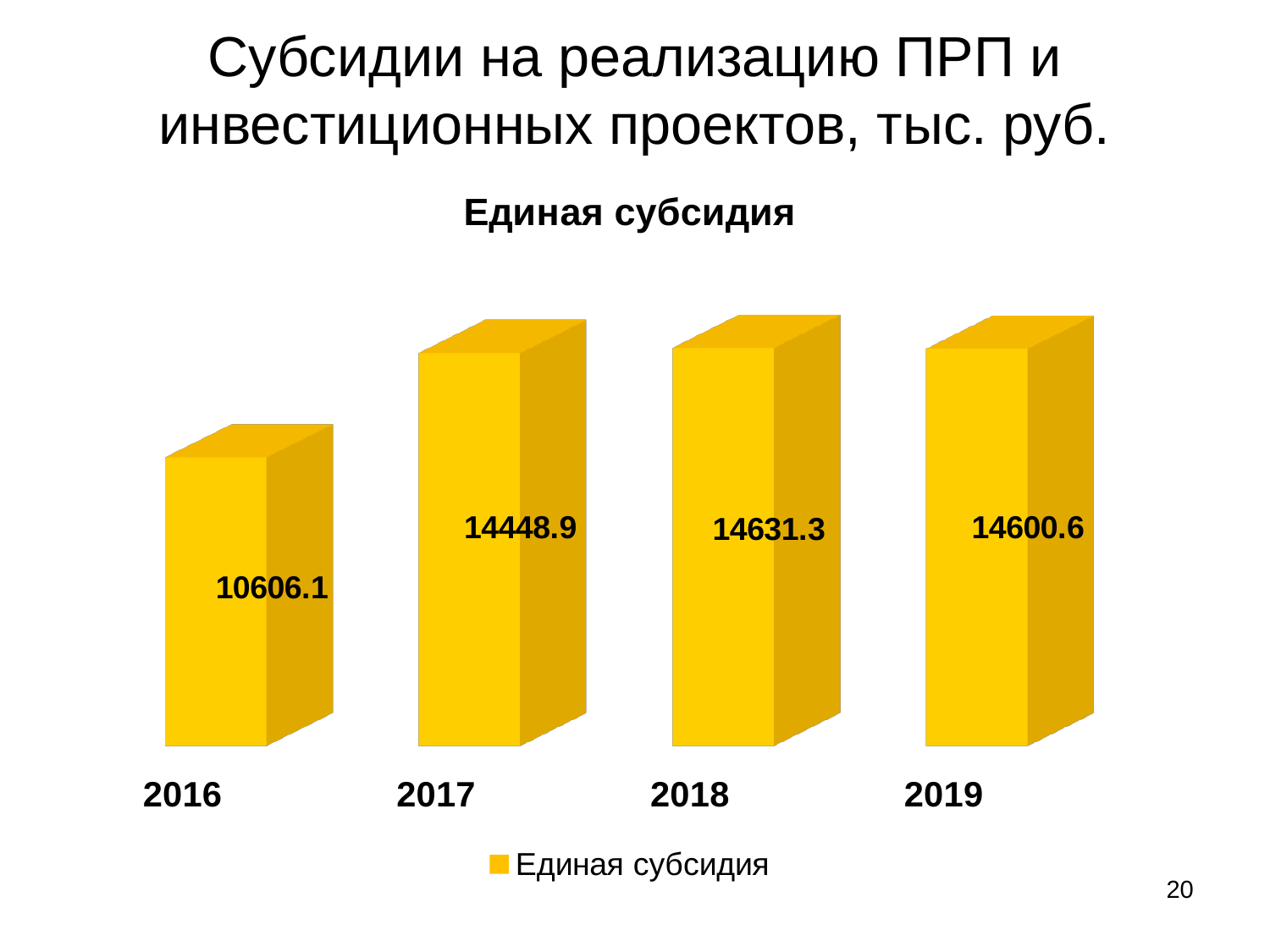
How many series does the legend list? 1 What is the difference between the values for 2017 and 2016? 3842.8 Which year has the highest value in the Единая субсидия chart? 2018 What is the value for 2017 in the Единая субсидия chart? 14448.9 How many years are shown in the chart? 4 What is the value for 2019 in the Единая субсидия chart? 14600.6 What is the value for 2016 in the Единая субсидия chart? 10606.1 What is the value for 2018 in the Единая субсидия chart? 14631.3 Which is larger, the value for 2016 or the value for 2017? 2017 What kind of chart is shown on the slide? Bar chart Which year has the lowest value in the Единая субсидия chart? 2016 What is the difference between the values for 2018 and 2019? 30.7